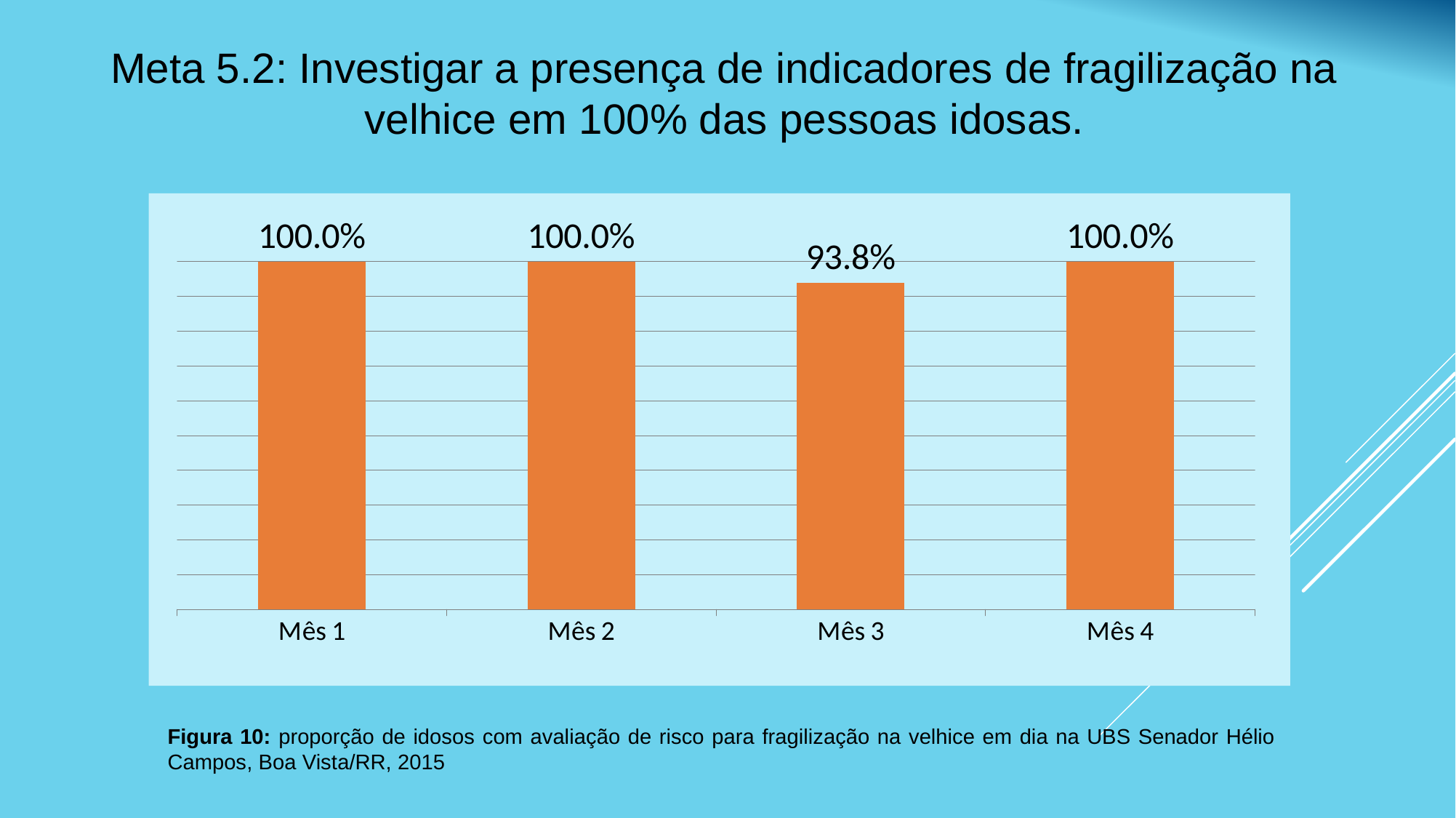
Which is larger, the value for Mês 3 or the value for Mês 4? Mês 4 What is the value for Mês 3? 93.8% What is the figure number given in the caption below the chart? Figura 10 Which month has the lowest value? Mês 3 How many months are shown on the x axis? 4 How many months have a value of 100.0%? 3 What is the value for Mês 1? 100.0% What is the difference between the values for Mês 2 and Mês 3? 6.2% Does the value fall or rise from Mês 3 to Mês 4? Rise What colour are the bars in the chart? Orange What kind of chart is shown on the slide? Bar chart What is the value for Mês 4? 100.0%